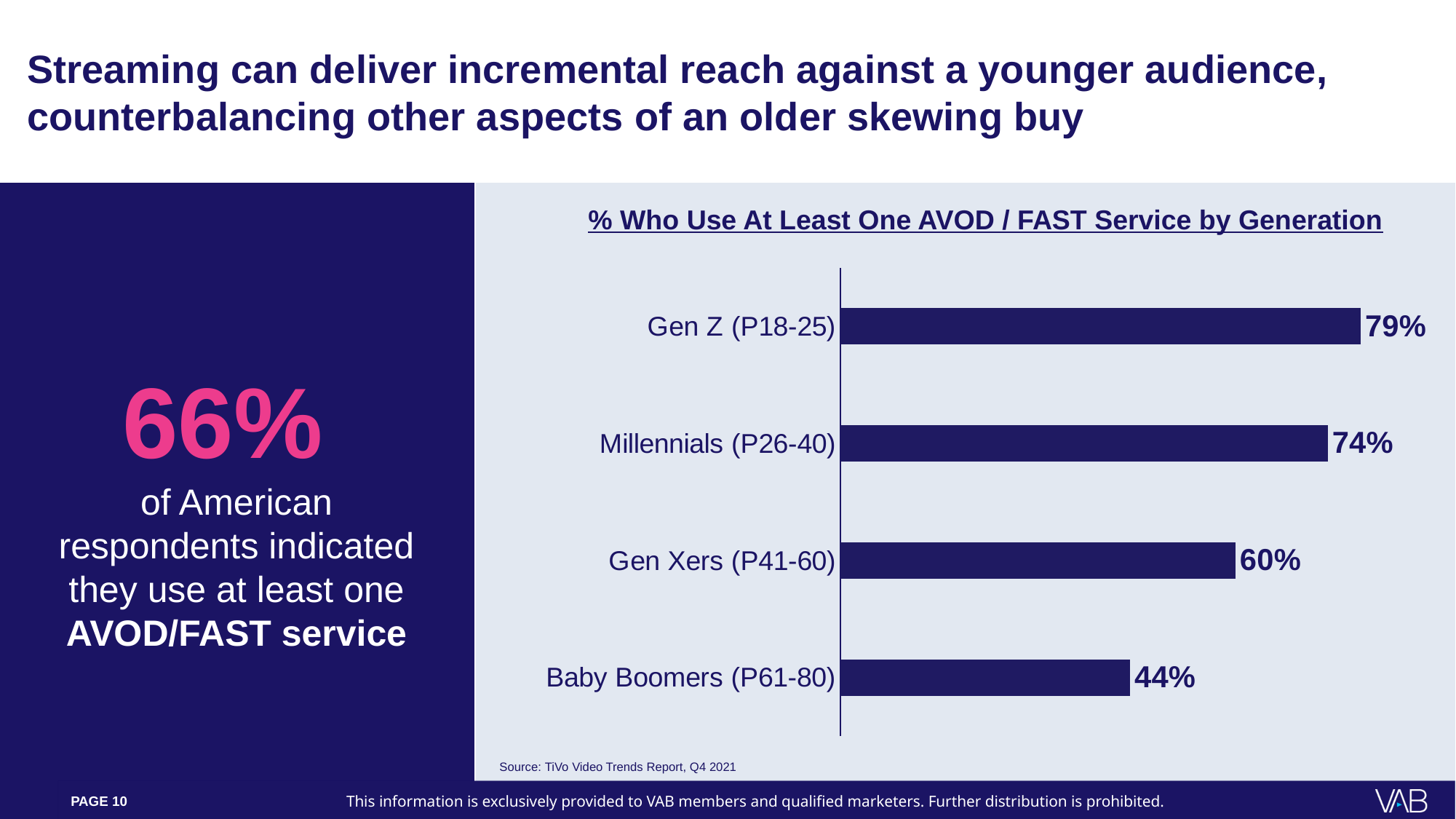
Which generation has the lowest share using at least one AVOD / FAST service? Baby Boomers (P61-80) What is the value shown for Millennials (P26-40)? 74% What is the difference between the values for Millennials (P26-40) and Gen Xers (P41-60)? 14 percentage points What percentage of Gen Z (P18-25) use at least one AVOD / FAST service? 79% What is the value shown for Gen Xers (P41-60)? 60% What percentage of Baby Boomers (P61-80) use at least one AVOD / FAST service? 44% Which generation has the highest share using at least one AVOD / FAST service? Gen Z (P18-25) What type of chart is used on this slide? Bar chart How many generations are shown in the chart? 4 What is the title of the chart? % Who Use At Least One AVOD / FAST Service by Generation What is the difference in percentage points between Gen Z (P18-25) and Baby Boomers (P61-80)? 35 percentage points Which is larger, the value for Millennials (P26-40) or the value for Gen Xers (P41-60)? Millennials (P26-40)